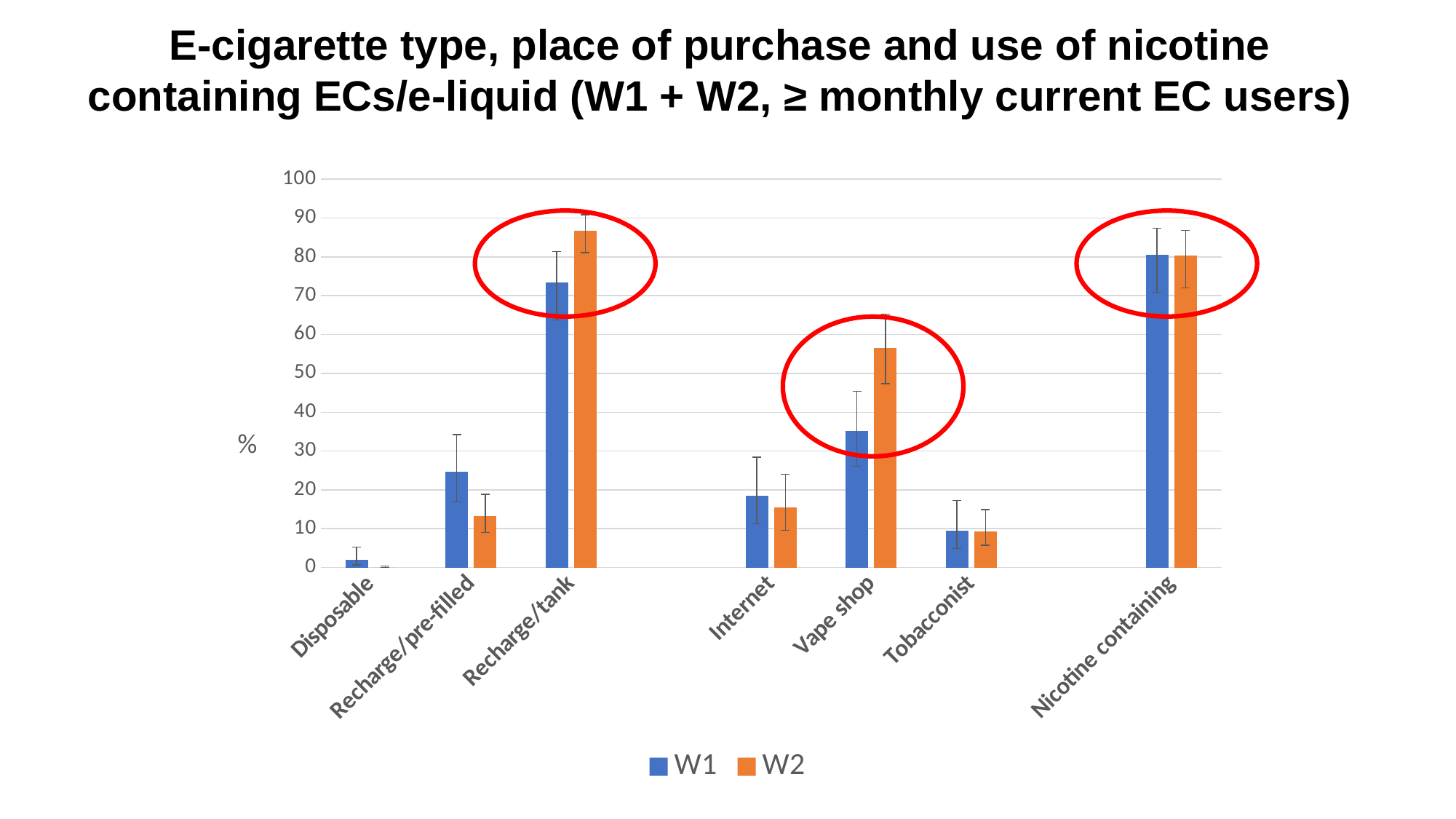
What kind of chart is shown on the slide? bar chart What label is shown on the vertical axis? % Is the W2 value for Vape shop greater or less than 50? greater Which category has the lowest W2 value? Disposable Is the W1 value for Recharge/tank greater or less than 70? greater How many categories are shown on the x axis? 7 Is the W1 value for Internet greater or less than 20? less Which category has the lowest W1 value? Disposable Which category has the highest W2 value? Recharge/tank For Vape shop, which is larger, W1 or W2? W2 How many series does the legend list? 2 For Recharge/pre-filled, which is larger, W1 or W2? W1